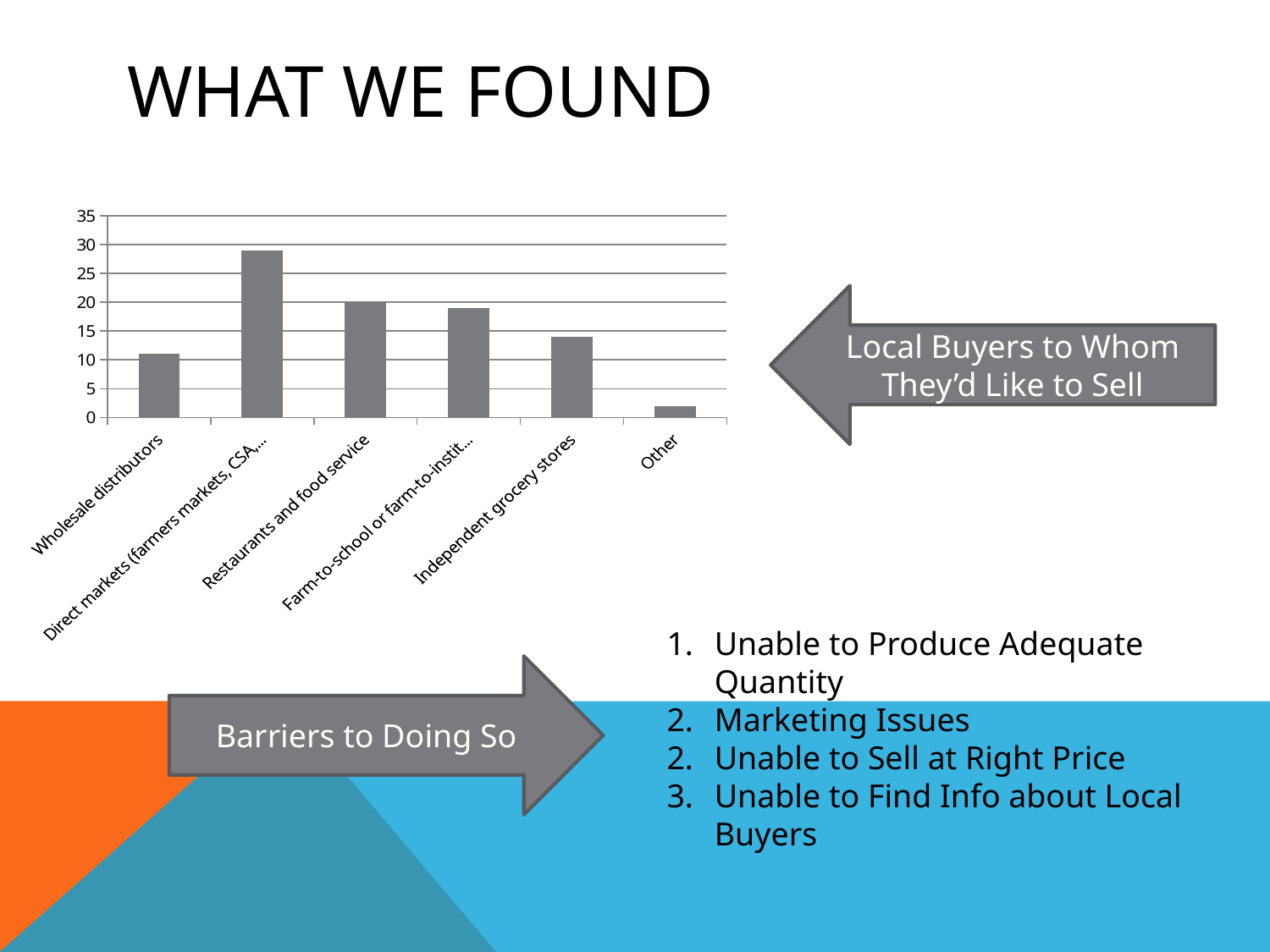
What does the arrow label pointing at the chart say the chart shows? Local Buyers to Whom They'd Like to Sell Which is larger in the chart: the value for Direct markets (farmers markets, CSA,...) or the value for Restaurants and food service? Direct markets (farmers markets, CSA,...) Is the value for Other greater or less than 5? less What kind of chart is shown on the slide? bar chart What is the highest value shown on the vertical axis of the chart? 35 Which is larger in the chart: the value for Wholesale distributors or the value for Independent grocery stores? Independent grocery stores Is the value for Wholesale distributors greater or less than 15? less Which category has the lowest bar in the chart? Other How many categories are shown on the x axis of the bar chart? 6 Which category has the highest bar in the chart? Direct markets (farmers markets, CSA,...) Is the value for Independent grocery stores greater or less than 10? greater